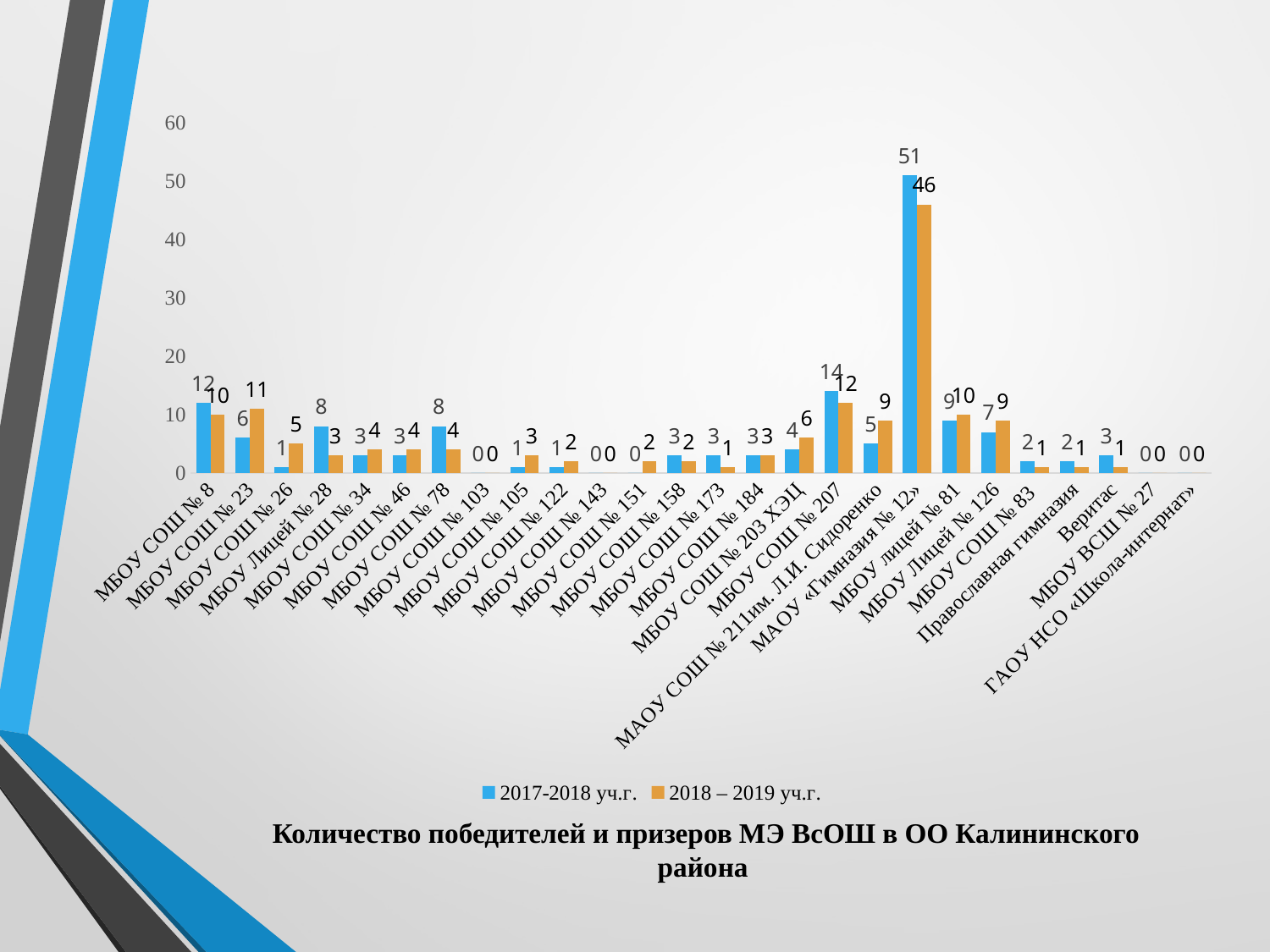
Which school has the highest value in the 2017-2018 уч.г. series? МАОУ «Гимназия № 12» How many schools (categories) are shown on the x axis? 26 What is the difference between the 2017-2018 уч.г. and 2018 – 2019 уч.г. values for МАОУ «Гимназия № 12»? 5 What is the difference between the 2017-2018 уч.г. and 2018 – 2019 уч.г. values for МБОУ Лицей № 28? 5 What is the value for МБОУ СОШ № 207 in the 2018 – 2019 уч.г. series? 12 What is the title of the chart? Количество победителей и призеров МЭ ВсОШ в ОО Калининского района Which is larger for МАОУ СОШ № 211 им. Л.И. Сидоренко: the 2017-2018 уч.г. value or the 2018 – 2019 уч.г. value? 2018 – 2019 уч.г. What type of chart is shown on the slide? Bar chart Which is larger for МБОУ СОШ № 8: the 2017-2018 уч.г. value or the 2018 – 2019 уч.г. value? 2017-2018 уч.г. How many series does the legend list? 2 What is the value for МАОУ «Гимназия № 12» in the 2017-2018 уч.г. series? 51 What is the value for МБОУ СОШ № 23 in the 2018 – 2019 уч.г. series? 11